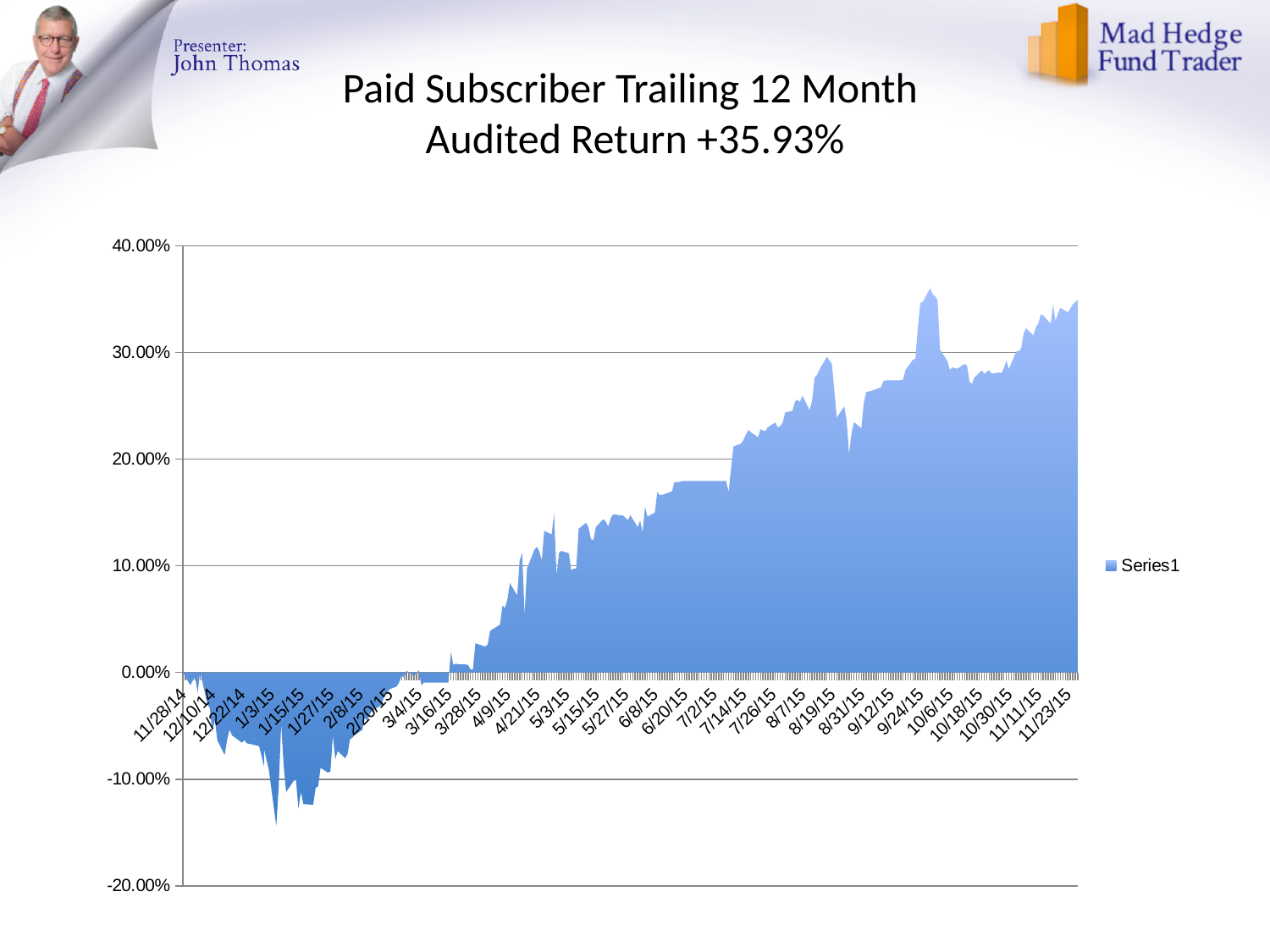
What is the name of the series shown in the legend? Series1 What kind of chart is shown on the slide? area chart Is the value for 6/20/15 greater or less than 10.00%? greater Is the value for 6/20/15 greater or less than 20.00%? less Is the lowest value on the chart greater or less than -10.00%? less What is the title of the chart on the slide? Paid Subscriber Trailing 12 Month Audited Return +35.93% Which is larger, the value for 9/24/15 or the value for 3/16/15? 9/24/15 Overall, do the values rise or fall from 11/28/14 to 11/23/15? rise How many series does the legend list? 1